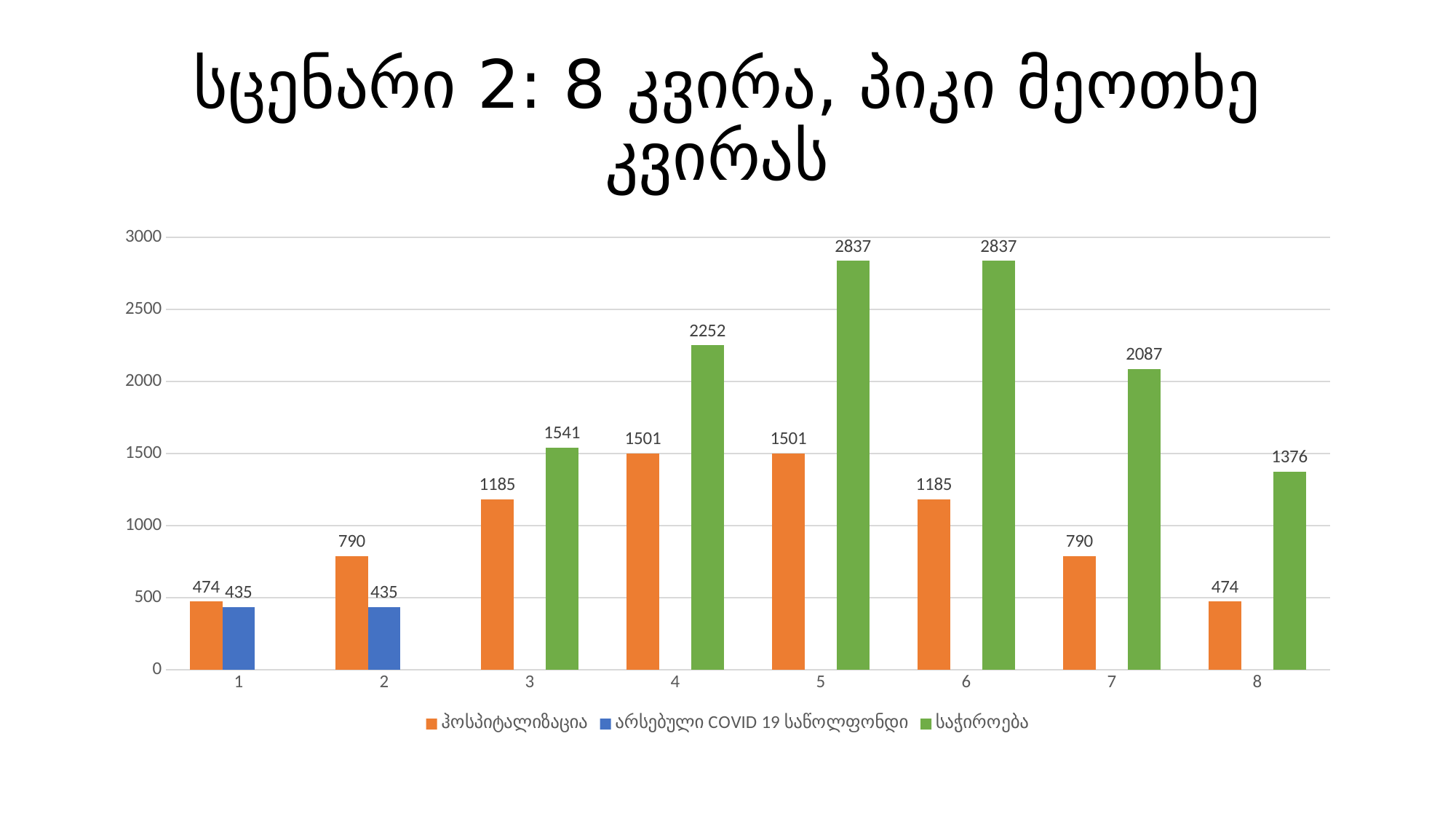
What is the value of ჰოსპიტალიზაცია for category 4? 1501 What kind of chart is shown on the slide? bar chart Which category has the highest value for ჰოსპიტალიზაცია? 4 and 5 What is the value of არსებული COVID 19 საწოლფონდი for category 2? 435 Which is larger for category 1: ჰოსპიტალიზაცია or არსებული COVID 19 საწოლფონდი? ჰოსპიტალიზაცია Which category has the lowest value for საჭიროება? 8 What colour are the bars for საჭიროება? green Does the value of ჰოსპიტალიზაცია rise or fall from category 5 to category 8? fall How many series does the legend list? 3 What is the difference between საჭიროება and ჰოსპიტალიზაცია for category 5? 1336 What is the value of საჭიროება for category 7? 2087 How many categories are shown on the x axis? 8